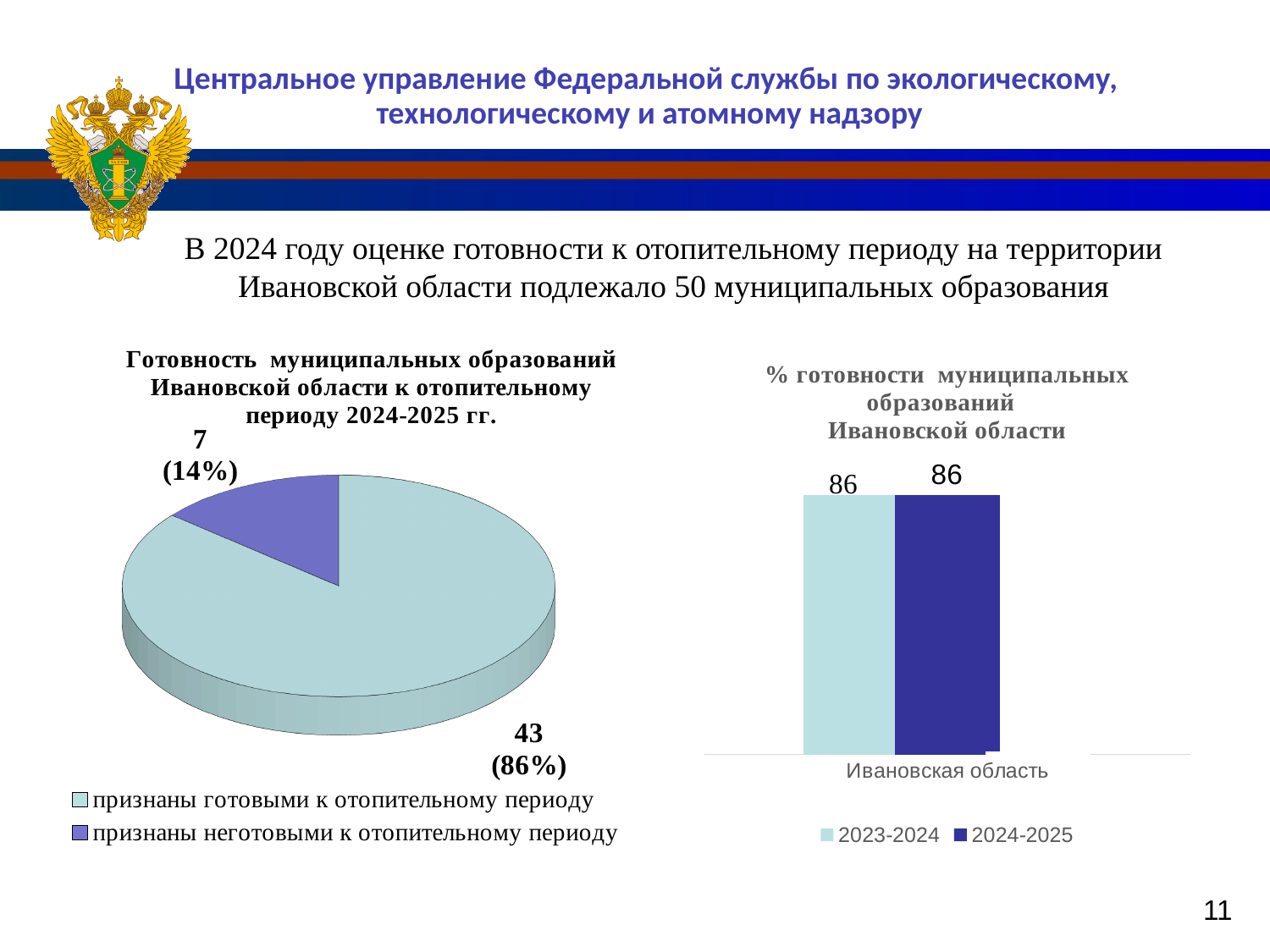
On the pie chart on the left, what share of the pie is the slice for municipalities recognised as not ready (признаны неготовыми)? 14% What kind of chart is the chart on the right of the slide? bar chart On the bar chart on the right, how many series does the legend list? 2 On the pie chart on the left, what share of the pie is the slice for municipalities recognised as ready (признаны готовыми)? 86% On the bar chart on the right (% готовности муниципальных образований Ивановской области), what is the value for 2023-2024? 86 On the pie chart on the left, how many municipalities were recognised as ready for the heating period (признаны готовыми к отопительному периоду)? 43 On the pie chart on the left, how many municipalities were recognised as not ready for the heating period (признаны неготовыми к отопительному периоду)? 7 On the pie chart on the left, what is the difference between the number of municipalities recognised as ready and those recognised as not ready? 36 On the pie chart on the left, how many slices does the pie have? 2 On the pie chart on the left, which slice is the largest? признаны готовыми к отопительному периоду What kind of chart is the chart on the left of the slide? pie chart On the bar chart on the right (% готовности муниципальных образований Ивановской области), what is the value for 2024-2025? 86